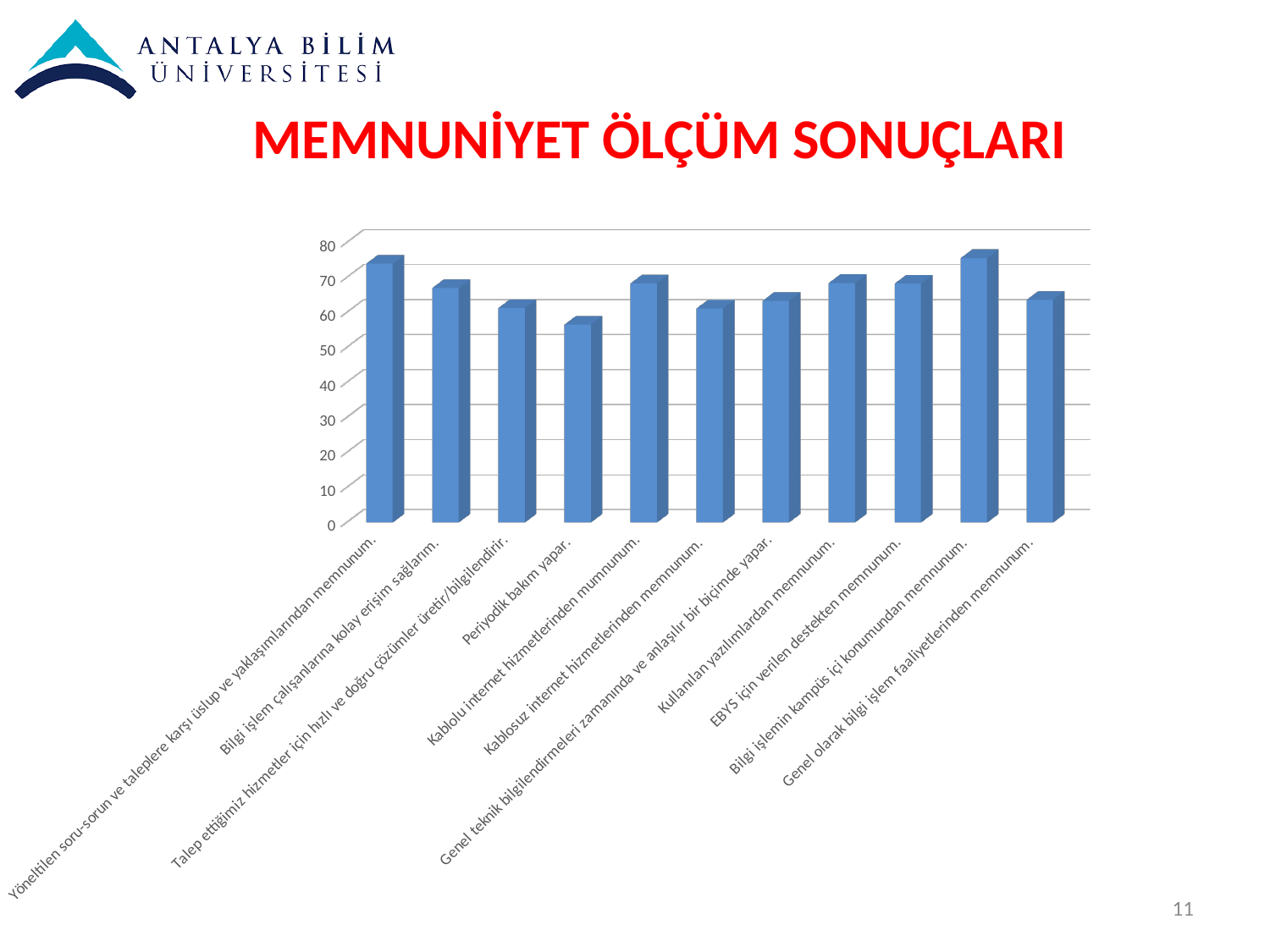
What kind of chart is shown on the slide? Bar chart How many categories (bars) are plotted in the chart? 11 What is the maximum value shown on the vertical axis of the chart? 80 Is the value for "Yöneltilen soru-sorun ve taleplere karşı üslup ve yaklaşımlarından memnunum." greater or less than 70? greater Which is larger: the value for "Periyodik bakım yapar." or the value for "Bilgi işlem çalışanlarına kolay erişim sağlarım."? Bilgi işlem çalışanlarına kolay erişim sağlarım. Is the value for "Periyodik bakım yapar." greater or less than 60? less Which category has the lowest bar in the chart? Periyodik bakım yapar. Is the value for "Kablolu internet hizmetlerinden mumnunum." greater or less than 60? greater What is the title of the slide containing the chart? MEMNUNİYET ÖLÇÜM SONUÇLARI Which category has the highest bar in the chart? Bilgi işlemin kampüs içi konumundan memnunum. Which is larger: the value for "Kablosuz internet hizmetlerinden memnunum." or the value for "Kullanılan yazılımlardan memnunum."? Kullanılan yazılımlardan memnunum.